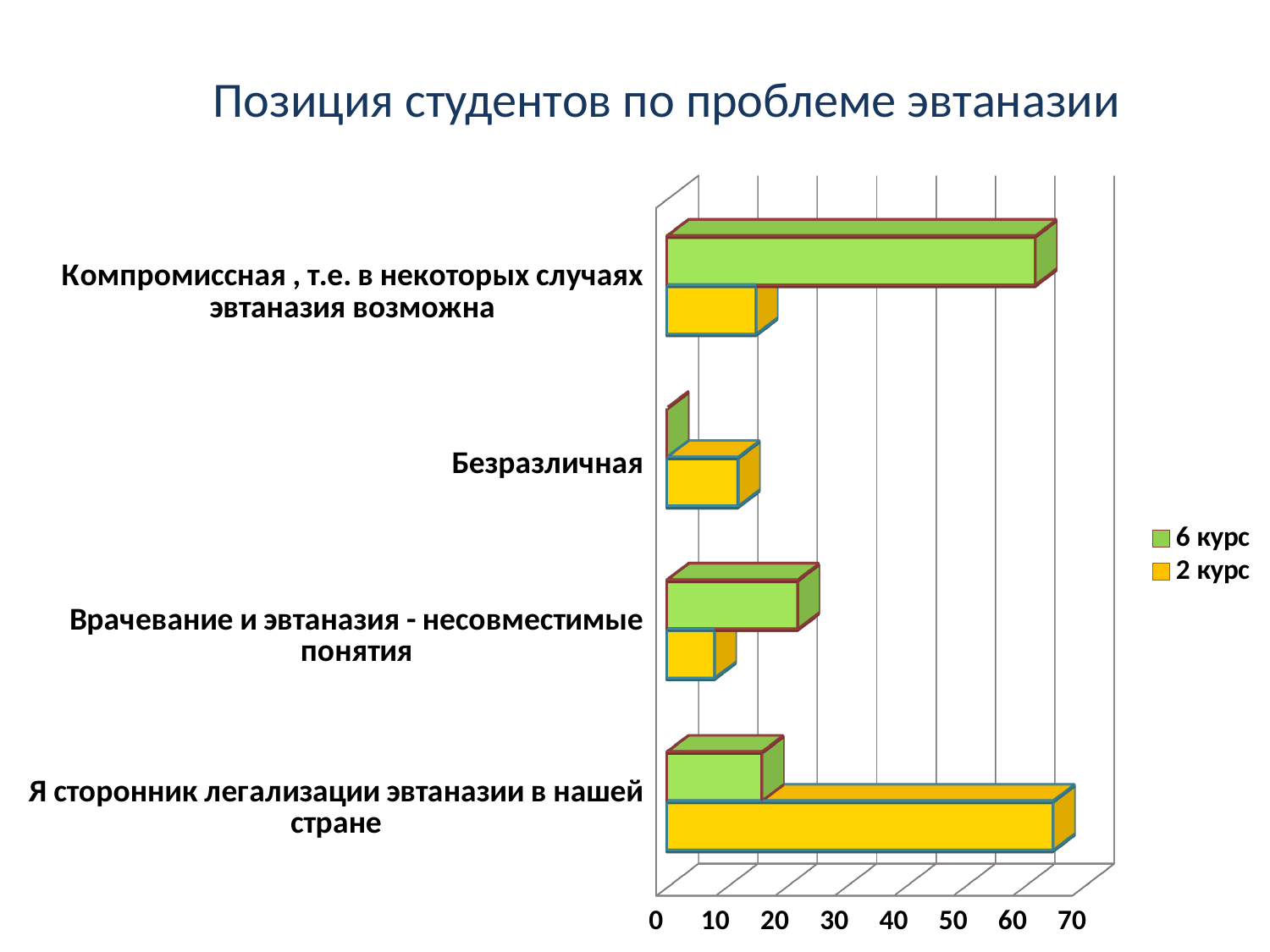
Which colour represents the series "2 курс"? yellow How many categories are shown on the chart? 4 In the category "Я сторонник легализации эвтаназии в нашей стране", which series has the larger value, "6 курс" or "2 курс"? 2 курс For the series "6 курс", which category has the highest value? Компромиссная , т.е. в некоторых случаях эвтаназия возможна Is the value for "2 курс" in the category "Я сторонник легализации эвтаназии в нашей стране" greater or less than 50? greater Is the value for "6 курс" in the category "Безразличная" greater or less than 10? less Is the value for "6 курс" in the category "Компромиссная , т.е. в некоторых случаях эвтаназия возможна" greater or less than 50? greater For the series "6 курс", which category has the lowest value? Безразличная What is the title of the chart? Позиция студентов по проблеме эвтаназии What kind of chart is shown on the slide? bar chart For the series "2 курс", which category has the highest value? Я сторонник легализации эвтаназии в нашей стране How many series does the legend list? 2